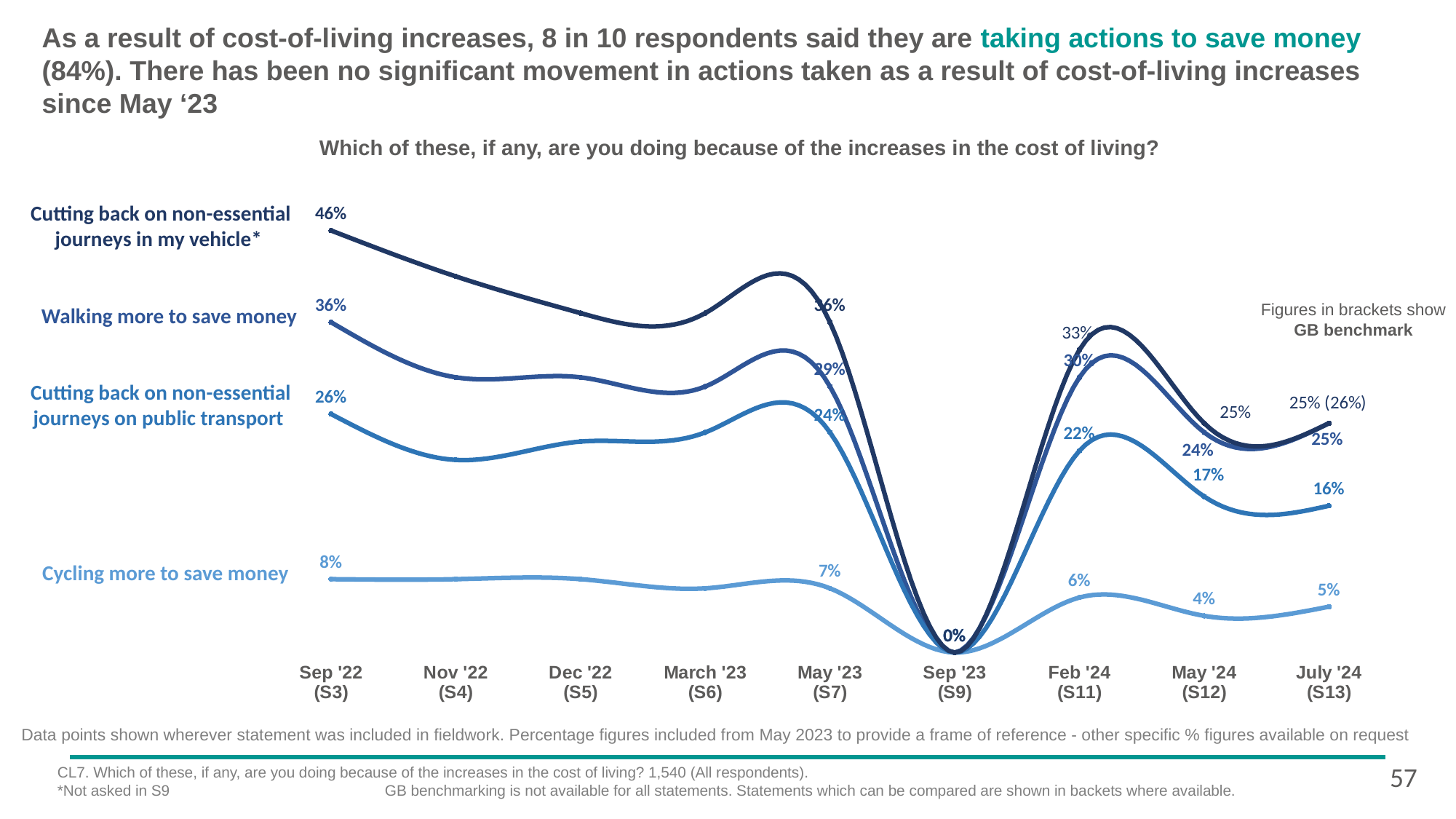
What percentage said they were walking more to save money in July '24 (S13)? 25% What percentage said they were cutting back on non-essential journeys on public transport in May '24 (S12)? 17% How many survey waves are shown along the x axis of the chart? 9 For 'Walking more to save money', was the value higher in Feb '24 (S11) or May '24 (S12)? Feb '24 (S11) What percentage said they were cycling more to save money in Sep '22 (S3)? 8% What percentage said they were cutting back on non-essential journeys in their vehicle in Sep '22 (S3)? 46% By how many percentage points did 'Cycling more to save money' fall from Sep '22 (S3) to July '24 (S13)? 3 percentage points Which statement had the lowest percentage in Feb '24 (S11)? Cycling more to save money How many statements (lines) are plotted on the chart? 4 What percentage said they were cutting back on non-essential journeys on public transport in Feb '24 (S11)? 22% What kind of chart is shown on the slide? Line chart Which statement had the highest percentage in Sep '22 (S3)? Cutting back on non-essential journeys in my vehicle